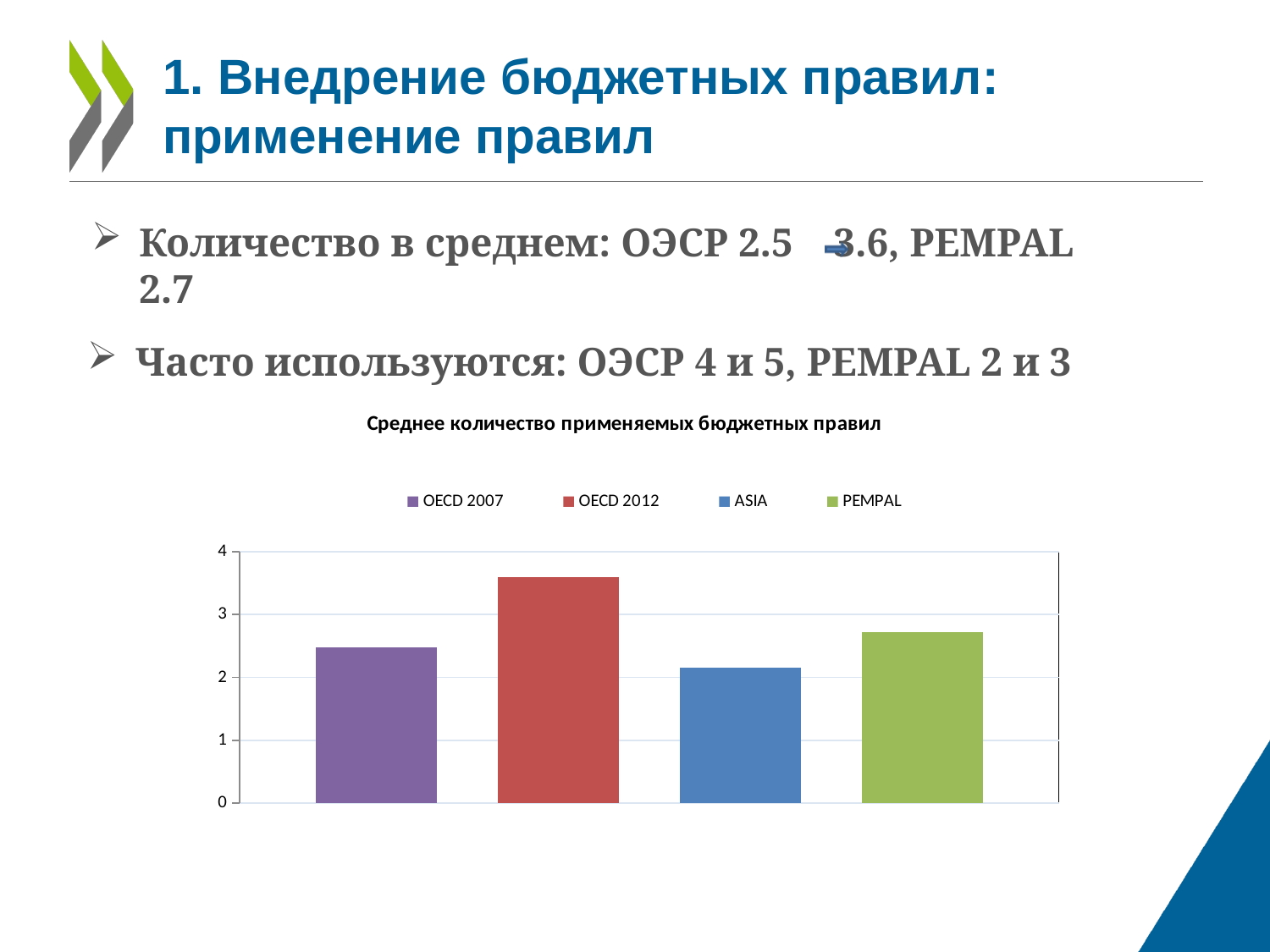
Which series has the highest bar in the chart? OECD 2012 Is the value for OECD 2007 greater or less than 3? less What colour is the bar for OECD 2012? red Which series has the lowest bar in the chart? ASIA What is the title of the chart? Среднее количество применяемых бюджетных правил Is the value for OECD 2012 greater or less than 3? greater Which is larger, the value for OECD 2012 or the value for PEMPAL? OECD 2012 What kind of chart is shown on the slide? bar chart How many series does the chart legend list? 4 Which is larger, the value for OECD 2007 or the value for ASIA? OECD 2007 Is the value for ASIA greater or less than 2? greater